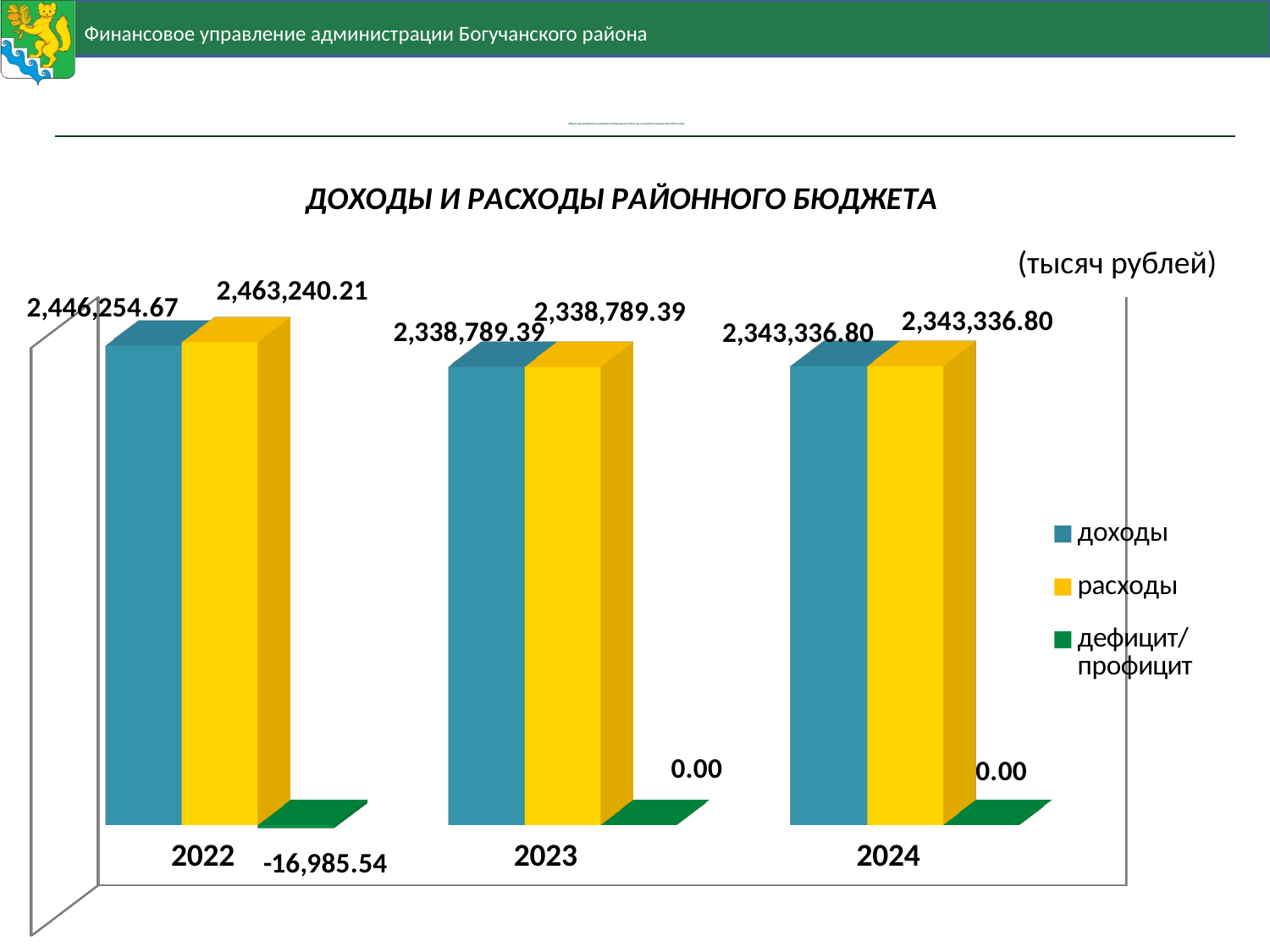
Which is larger in 2022, доходы or расходы? расходы What is the value of доходы for 2022? 2,446,254.67 What kind of chart is shown on the slide? bar chart What is the value of расходы for 2024? 2,343,336.80 In which year is доходы the highest? 2022 How many series does the legend list? 3 What is the difference between расходы and доходы in 2022? 16,985.54 How many years are shown on the x axis? 3 What is the value of дефицит/профицит for 2022? -16,985.54 What is the value of дефицит/профицит for 2023? 0.00 In which year is расходы the lowest? 2023 What is the value of расходы for 2022? 2,463,240.21